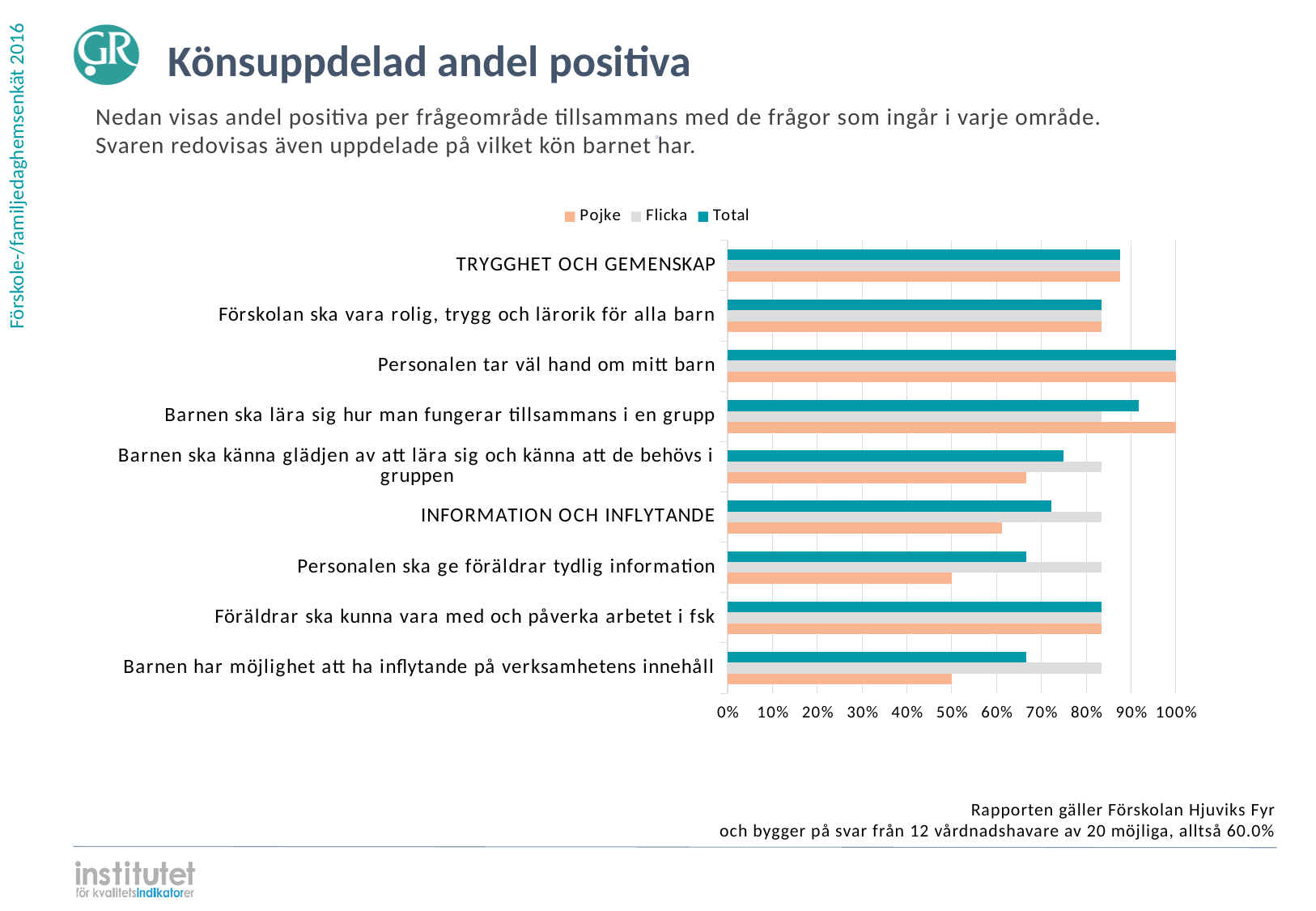
What kind of chart is shown on the slide? bar chart Which category has the highest Total value? Personalen tar väl hand om mitt barn For 'Barnen har möjlighet att ha inflytande på verksamhetens innehåll', which is larger, the Pojke value or the Flicka value? Flicka Which colour represents the Total series? teal Is the Total value for 'TRYGGHET OCH GEMENSKAP' greater or less than 80%? greater Is the Pojke value for 'INFORMATION OCH INFLYTANDE' greater or less than 70%? less What is the Total value for 'Personalen tar väl hand om mitt barn'? 100% How many categories are plotted on the y axis? 9 How many series does the legend list? 3 What is the Pojke value for 'Barnen ska lära sig hur man fungerar tillsammans i en grupp'? 100% What is the Pojke value for 'Personalen ska ge föräldrar tydlig information'? 50% What are the three series named in the legend? Pojke, Flicka, Total